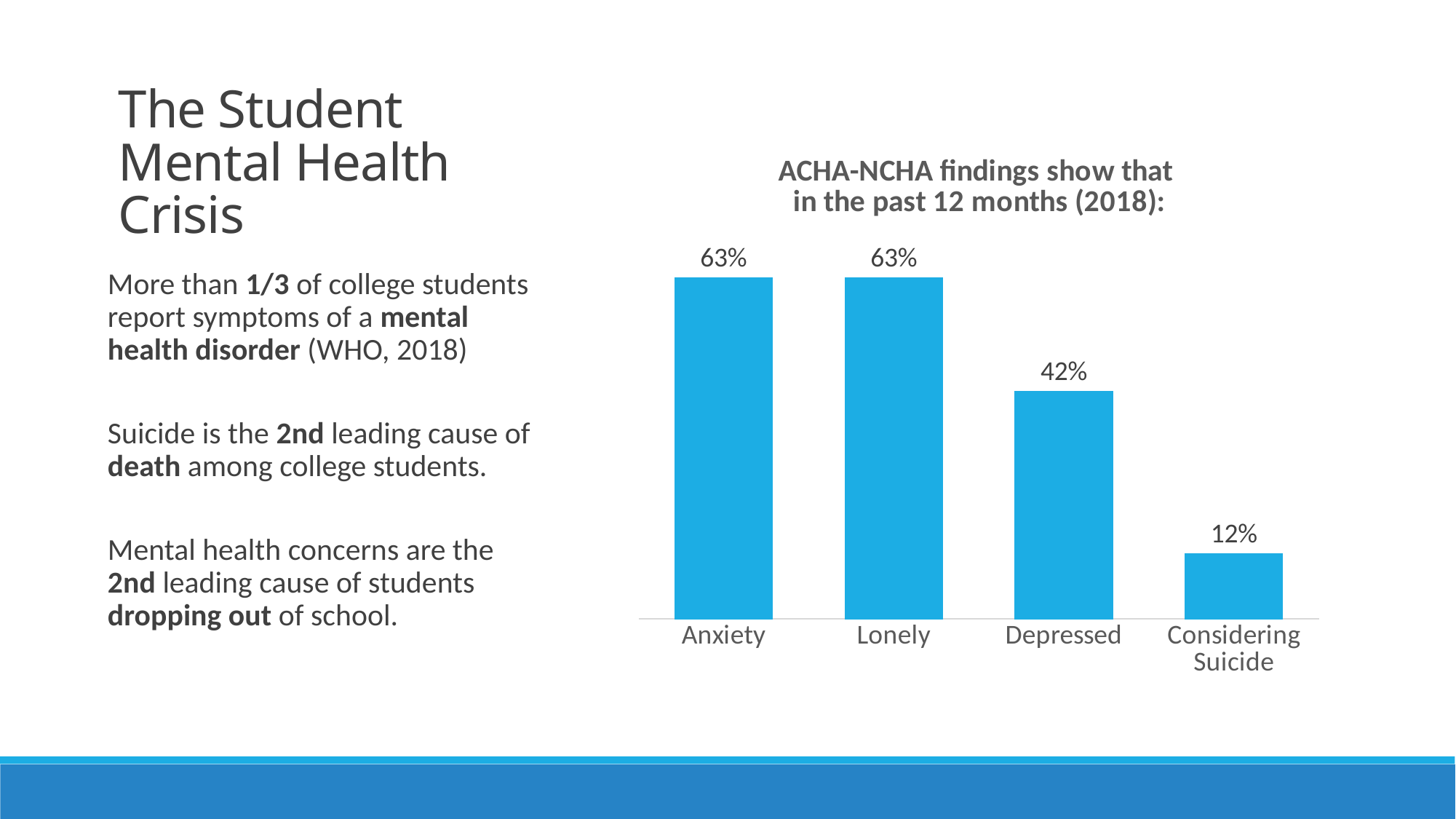
What is the value for Considering Suicide? 12% What is the difference between the values for Anxiety and Depressed? 21% What is the title of the chart? ACHA-NCHA findings show that in the past 12 months (2018): What is the value for Lonely? 63% What is the value for Anxiety? 63% How many categories are shown in the chart? 4 What kind of chart is shown on the slide? Bar chart Which category has the lowest value? Considering Suicide What is the value for Depressed? 42% Which is larger, the value for Depressed or the value for Considering Suicide? Depressed What is the difference between the values for Depressed and Considering Suicide? 30% Which is larger, the value for Lonely or the value for Depressed? Lonely